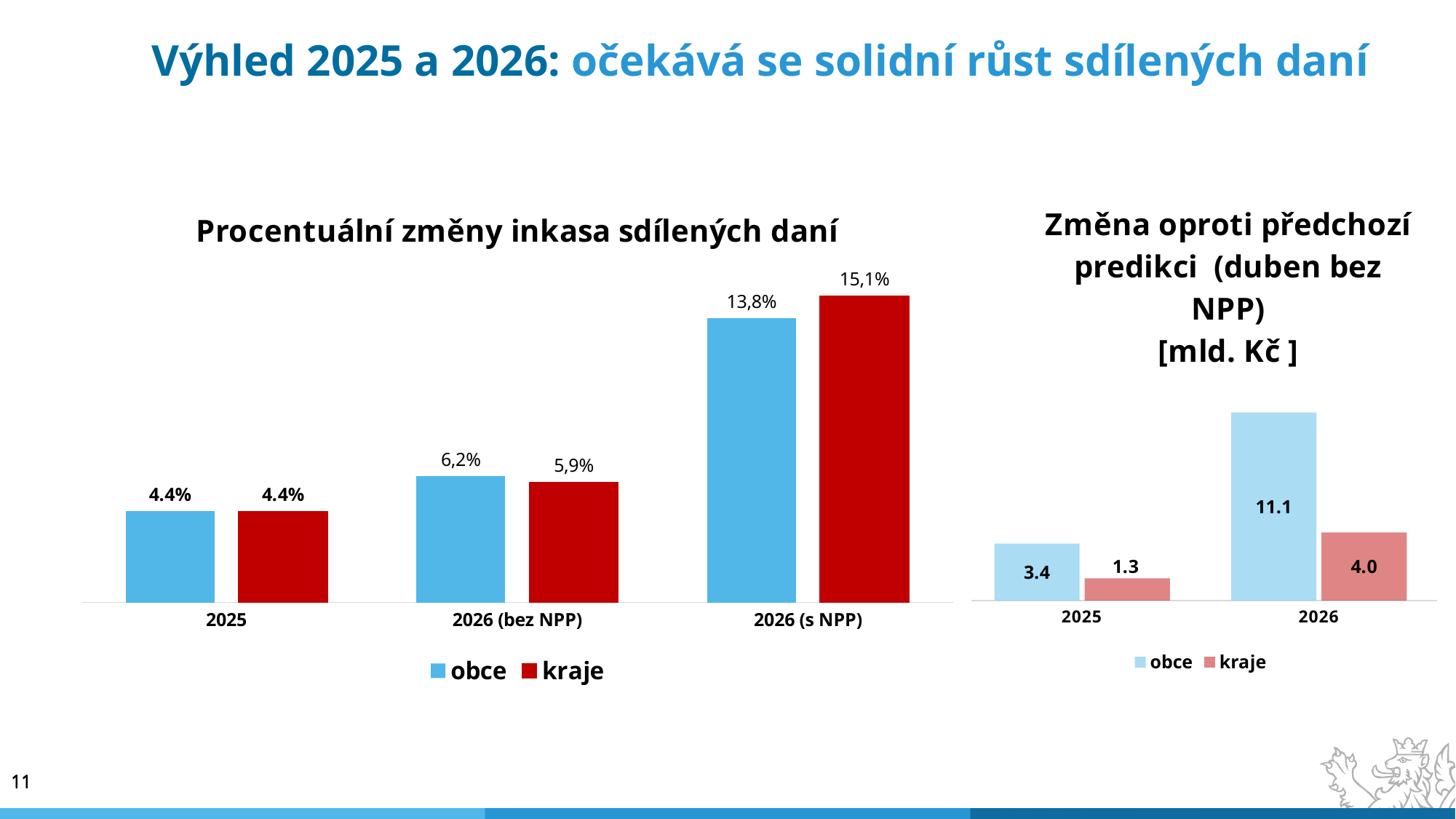
In the chart titled 'Procentuální změny inkasa sdílených daní', how many categories are shown on the x axis? 3 In the chart titled 'Procentuální změny inkasa sdílených daní', what is the value for kraje in 2026 (bez NPP)? 5,9% In the chart titled 'Procentuální změny inkasa sdílených daní', which category has the highest value for kraje? 2026 (s NPP) In the chart on the right, 'Změna oproti předchozí predikci', which series has the lowest value in 2025? kraje In the chart titled 'Procentuální změny inkasa sdílených daní', which is larger in 2026 (s NPP): obce or kraje? kraje What type of chart is the chart on the right of the slide? bar chart In the chart on the right, 'Změna oproti předchozí predikci', what is the value for obce in 2026? 11.1 In the chart titled 'Procentuální změny inkasa sdílených daní', what is the value for obce in 2025? 4.4% In the chart on the right, 'Změna oproti předchozí predikci', what is the value for kraje in 2025? 1.3 In the chart on the right, 'Změna oproti předchozí predikci', what is the difference between obce and kraje in 2026? 7.1 In the chart titled 'Procentuální změny inkasa sdílených daní', how many series does the legend list? 2 In the chart titled 'Procentuální změny inkasa sdílených daní', what is the value for obce in 2026 (s NPP)? 13,8%